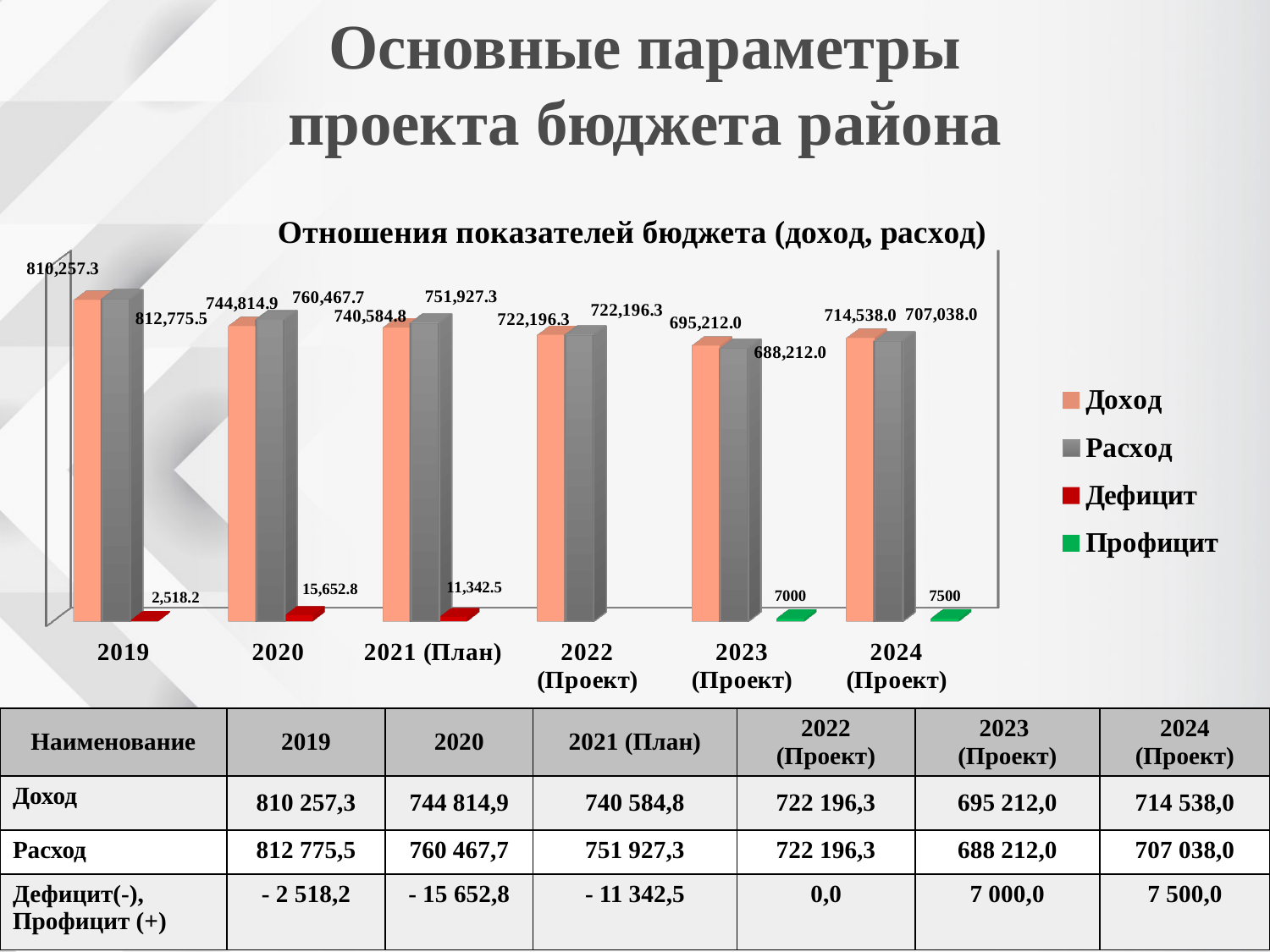
What is the title of the chart? Отношения показателей бюджета (доход, расход) What is the value of Доход for 2019? 810,257.3 What type of chart is shown? bar chart What is the difference between Расход and Доход in 2021 (План)? 11,342.5 What is the value of Расход for 2020? 760,467.7 How many year categories are shown on the x axis? 6 What is the Профицит value shown for 2024 (Проект)? 7500 How many series does the legend list? 4 Which is larger in 2020, Доход or Расход? Расход Which year has the lowest Доход value? 2023 (Проект) Which year has the highest Доход value? 2019 What is the value of Расход for 2023 (Проект)? 688,212.0